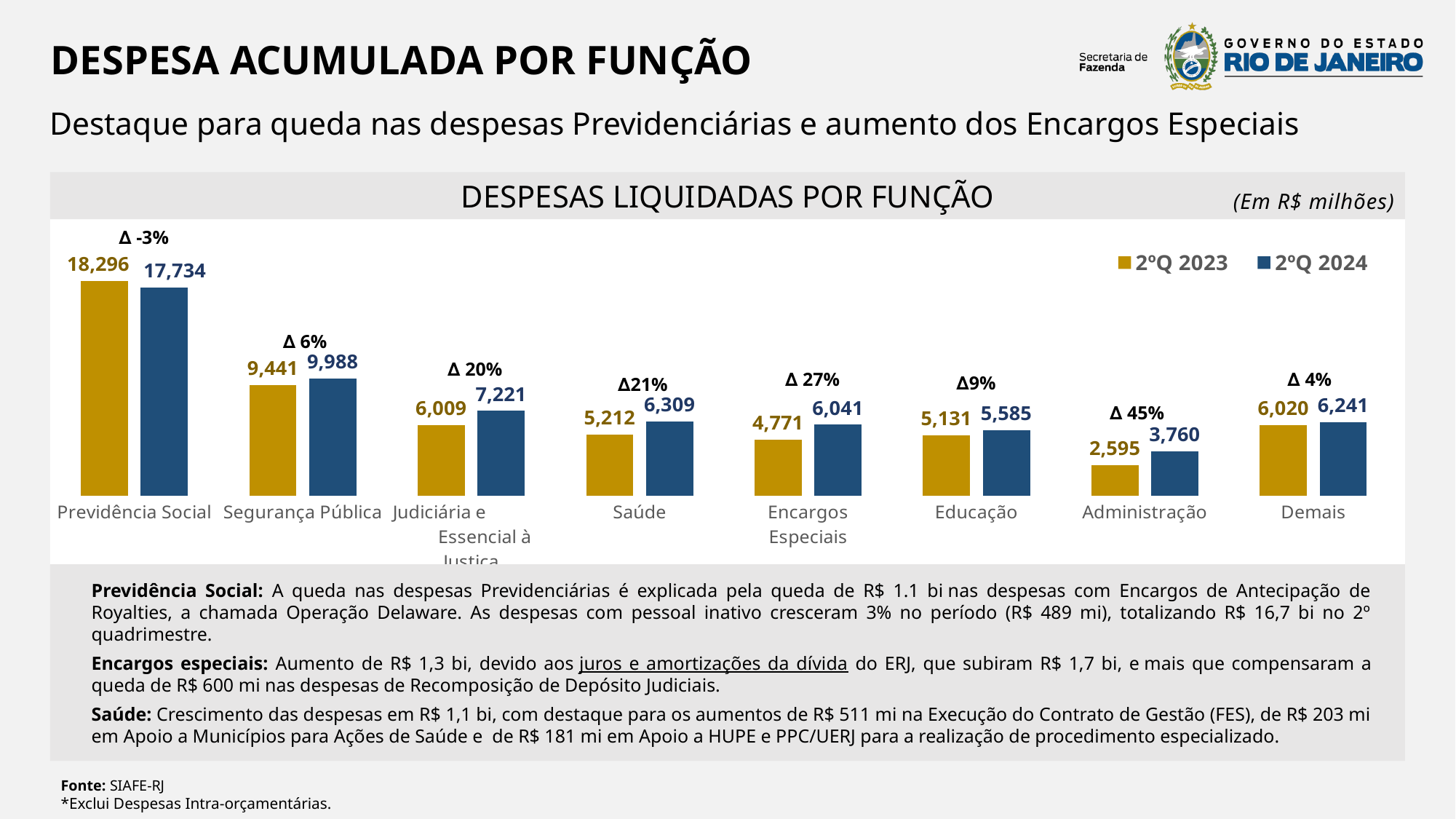
What kind of chart is shown? Bar chart What percentage change is shown above the Administração bars? Δ 45% What is the difference between the 2ºQ 2024 and 2ºQ 2023 values for Encargos Especiais? 1,270 What is the value for Administração in 2ºQ 2024? 3,760 How many series does the legend list? 2 Which category has the highest value in 2ºQ 2023? Previdência Social How many categories are shown on the x axis? 8 Which category has the lowest value in 2ºQ 2024? Administração Which is larger for Segurança Pública: the 2ºQ 2023 value or the 2ºQ 2024 value? 2ºQ 2024 What unit is stated for the chart values? Em R$ milhões What is the value for Saúde in 2ºQ 2023? 5,212 What is the value for Previdência Social in 2ºQ 2024? 17,734